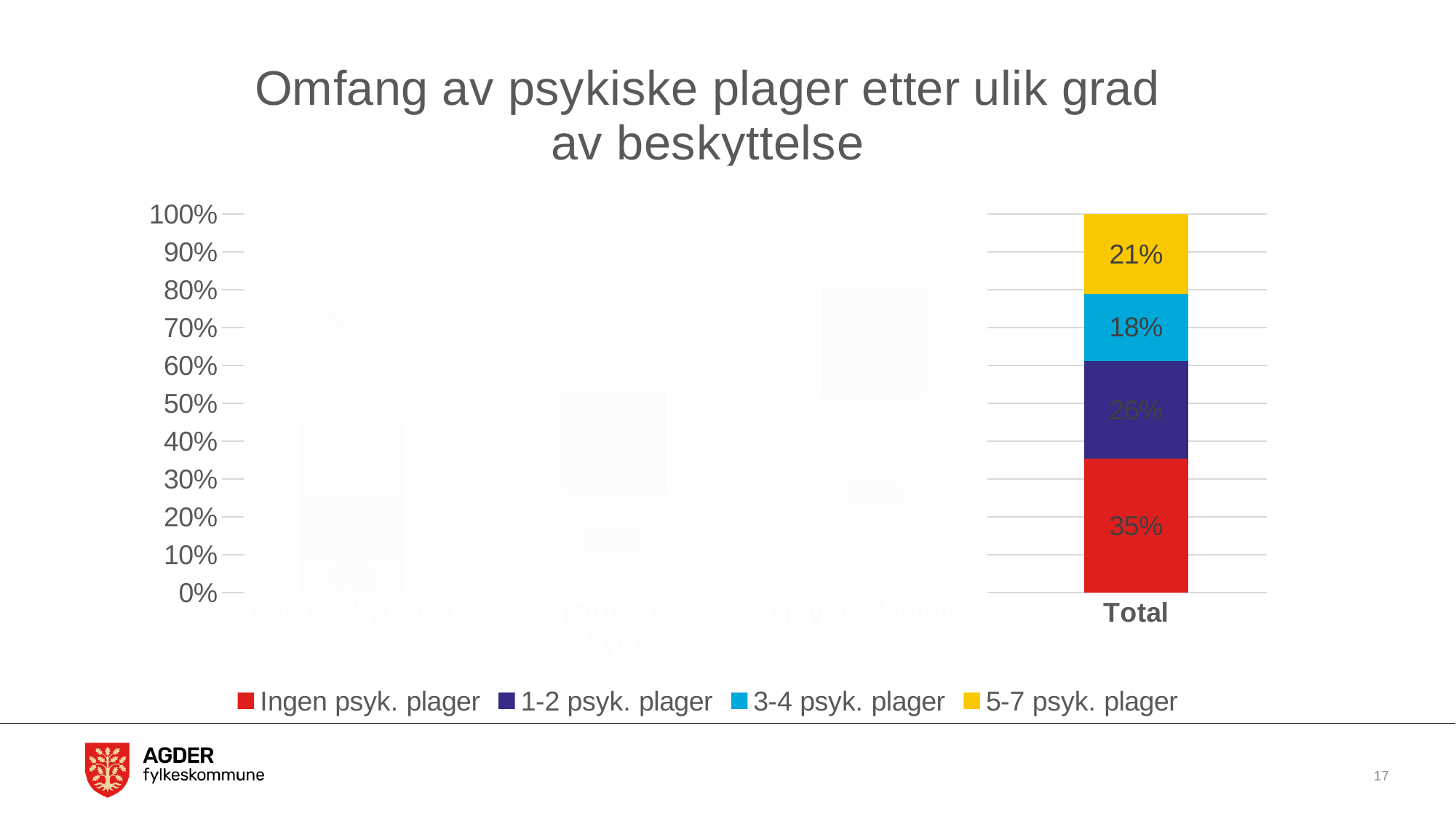
In the Total bar, what is the value for 5-7 psyk. plager? 21% In the Total bar, which is larger: 5-7 psyk. plager or 3-4 psyk. plager? 5-7 psyk. plager In the Total bar, what is the value for 3-4 psyk. plager? 18% What kind of chart is shown on the slide? Stacked bar chart How many series does the legend list? 4 What colour represents 5-7 psyk. plager in the legend? Yellow Which series has the smallest share in the Total bar? 3-4 psyk. plager What is the total of all segments in the Total bar? 100% Which series has the largest share in the Total bar? Ingen psyk. plager In the Total bar, what is the value for 1-2 psyk. plager? 26% In the Total bar, what is the value for Ingen psyk. plager? 35% In the Total bar, what is the difference between Ingen psyk. plager and 1-2 psyk. plager? 9%